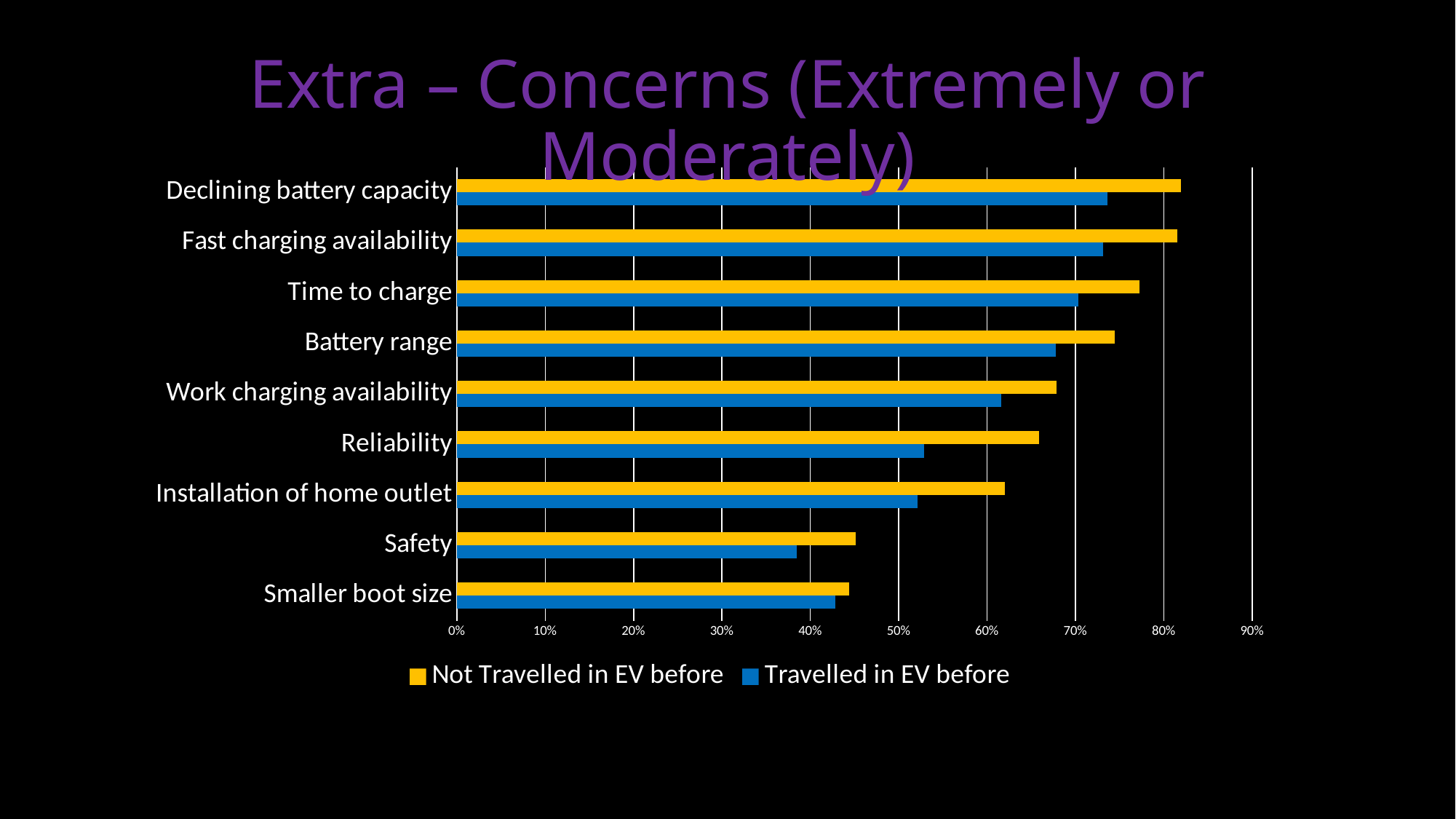
Is the value for Battery range in the Not Travelled in EV before series greater or less than 70%? greater What kind of chart is shown on the slide? Bar chart How many concern categories are listed on the chart? 9 Is the value for Safety in the Not Travelled in EV before series greater or less than 40%? greater Is the value for Reliability in the Travelled in EV before series greater or less than 60%? less Which colour represents the Travelled in EV before series? Blue How many series does the legend list? 2 Which category has the lowest value for the Travelled in EV before series? Safety For Reliability, which series has the larger value: Not Travelled in EV before or Travelled in EV before? Not Travelled in EV before In the Travelled in EV before series, which is larger: Safety or Smaller boot size? Smaller boot size